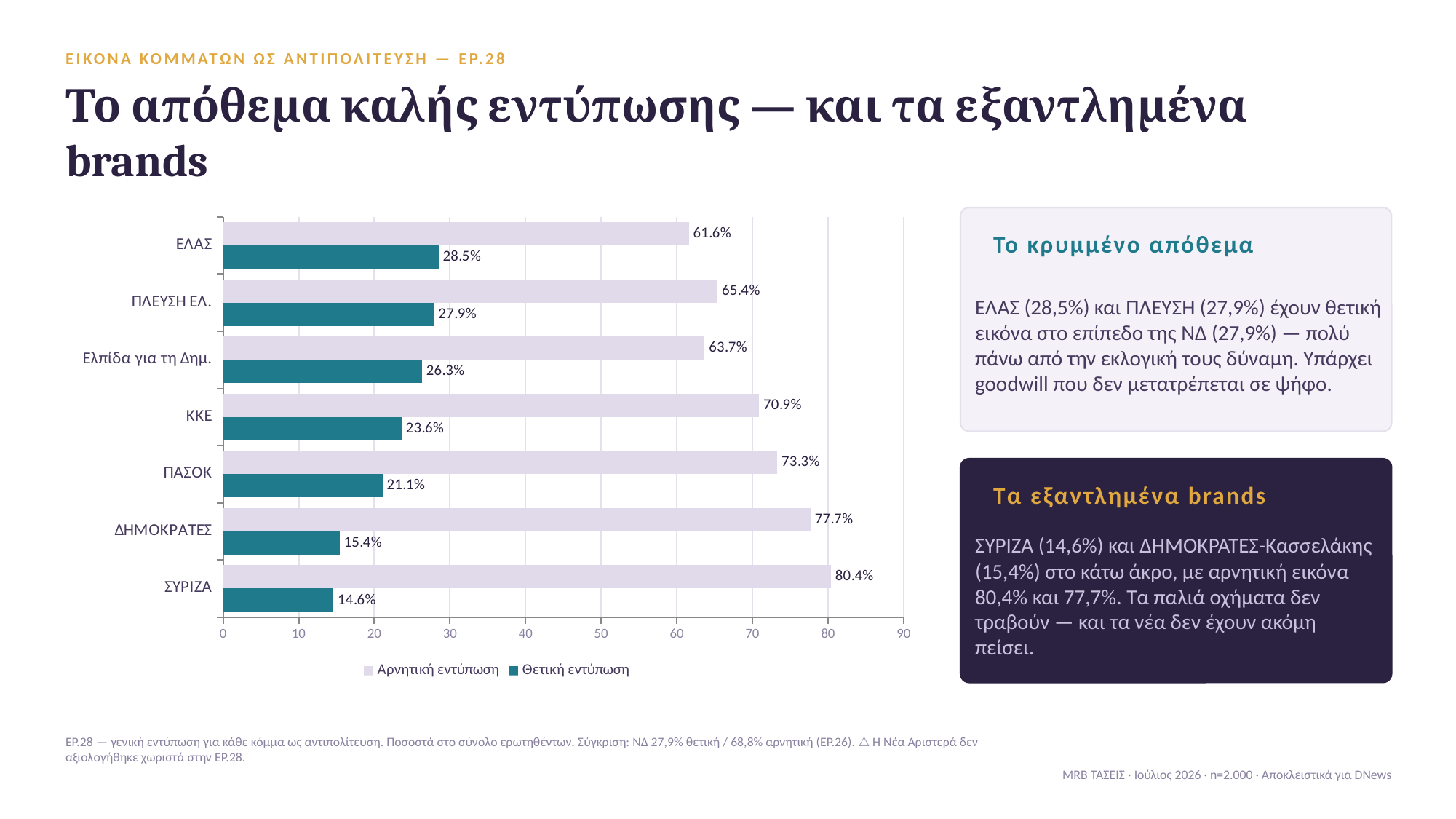
How many parties are shown on the chart? 7 Which series is shown in teal in the legend? Θετική εντύπωση What is the Θετική εντύπωση value for ΕΛΑΣ? 28.5% What is the Αρνητική εντύπωση value for ΣΥΡΙΖΑ? 80.4% Which party has the highest Αρνητική εντύπωση value? ΣΥΡΙΖΑ Is the Αρνητική εντύπωση value for ΚΚΕ greater or less than 60? greater How many series does the legend list? 2 Which is larger: the Θετική εντύπωση value for ΠΛΕΥΣΗ ΕΛ. or for Ελπίδα για τη Δημ.? ΠΛΕΥΣΗ ΕΛ. What kind of chart is shown on the slide? Bar chart Which party has the lowest Θετική εντύπωση value? ΣΥΡΙΖΑ What is the difference between the Αρνητική εντύπωση and Θετική εντύπωση values for ΠΑΣΟΚ? 52.2% What is the Θετική εντύπωση value for ΚΚΕ? 23.6%